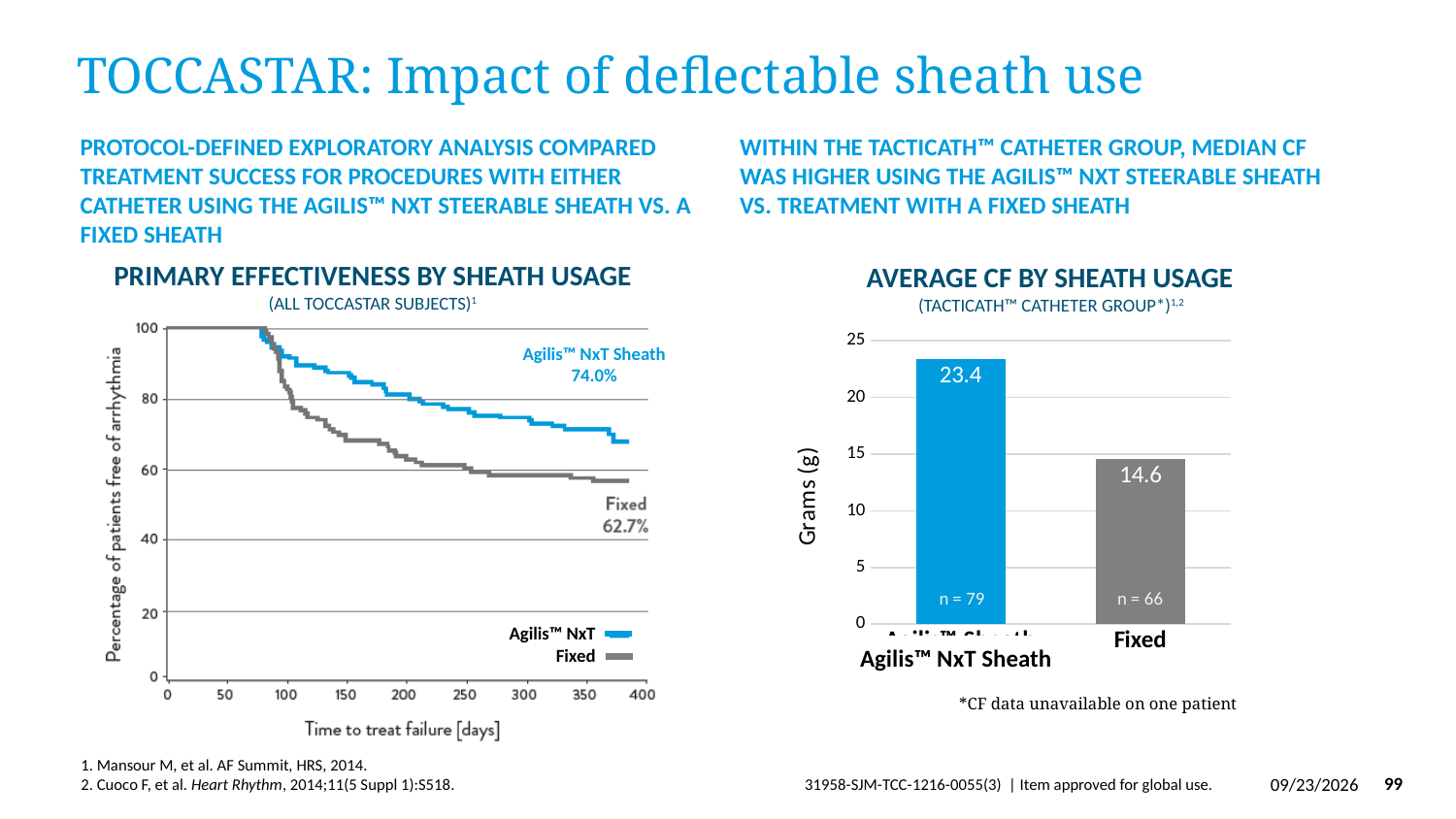
In the 'Average CF by Sheath Usage' chart, what is the n value shown for the Fixed sheath bar? n = 66 In the 'Average CF by Sheath Usage' chart, what is the difference between the Agilis NxT Sheath and Fixed values? 8.8 In the 'Primary Effectiveness by Sheath Usage' chart, what percentage is labelled for the Fixed sheath? 62.7% What type of chart is 'Average CF by Sheath Usage'? bar chart In the 'Average CF by Sheath Usage' chart, what unit is shown on the y-axis? Grams (g) In the 'Primary Effectiveness by Sheath Usage' chart, how many series does the legend list? 2 In the 'Average CF by Sheath Usage' chart, what is the value for the Fixed sheath? 14.6 In the 'Average CF by Sheath Usage' chart, which sheath has the higher average CF? Agilis NxT Sheath In the 'Average CF by Sheath Usage' chart, what is the value for the Agilis NxT Sheath? 23.4 In the 'Average CF by Sheath Usage' chart, how many bars are shown? 2 In the 'Average CF by Sheath Usage' chart, is the value for the Fixed sheath greater or less than 15? less In the 'Primary Effectiveness by Sheath Usage' chart, what percentage is labelled for the Agilis NxT Sheath? 74.0%